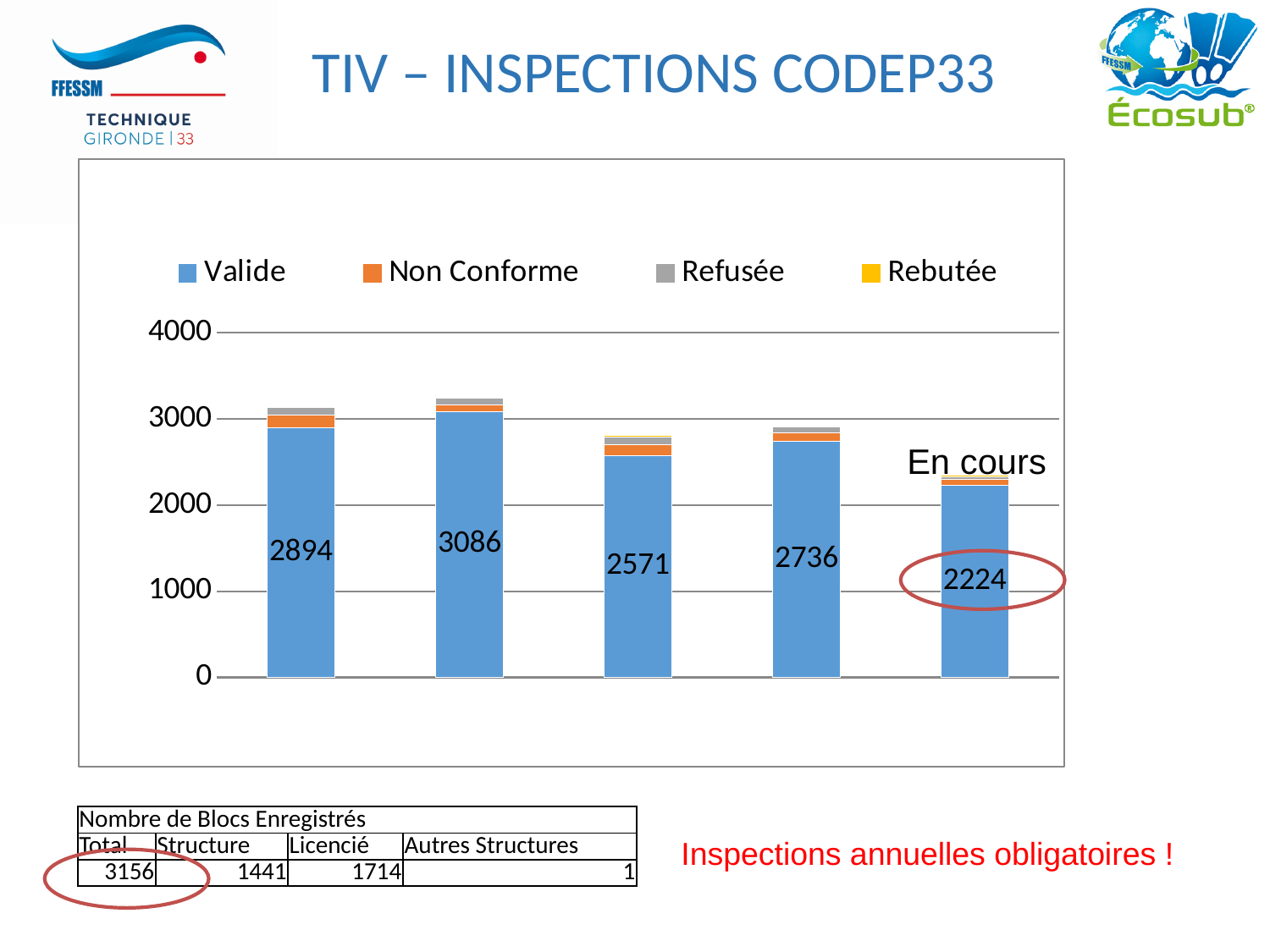
How many series does the chart legend list? 4 What kind of chart is shown on the slide? bar chart What is the difference between the Valide values of the second bar (3086) and the first bar (2894)? 192 Which is larger, the Valide value of the first bar or of the third bar? the first bar (2894) Is the total height of the second stacked bar greater or less than 3000? greater Which bar has the highest labelled Valide value? the second bar (3086) Which bar has the lowest labelled Valide value? the last bar, "En cours" (2224) What is the Valide value labelled on the second bar from the left? 3086 Does the Valide value rise or fall from the fourth bar to the fifth bar? fall Which legend entry is shown in blue? Valide How many stacked bars are plotted in the chart? 5 What is the Valide value labelled on the bar annotated "En cours"? 2224